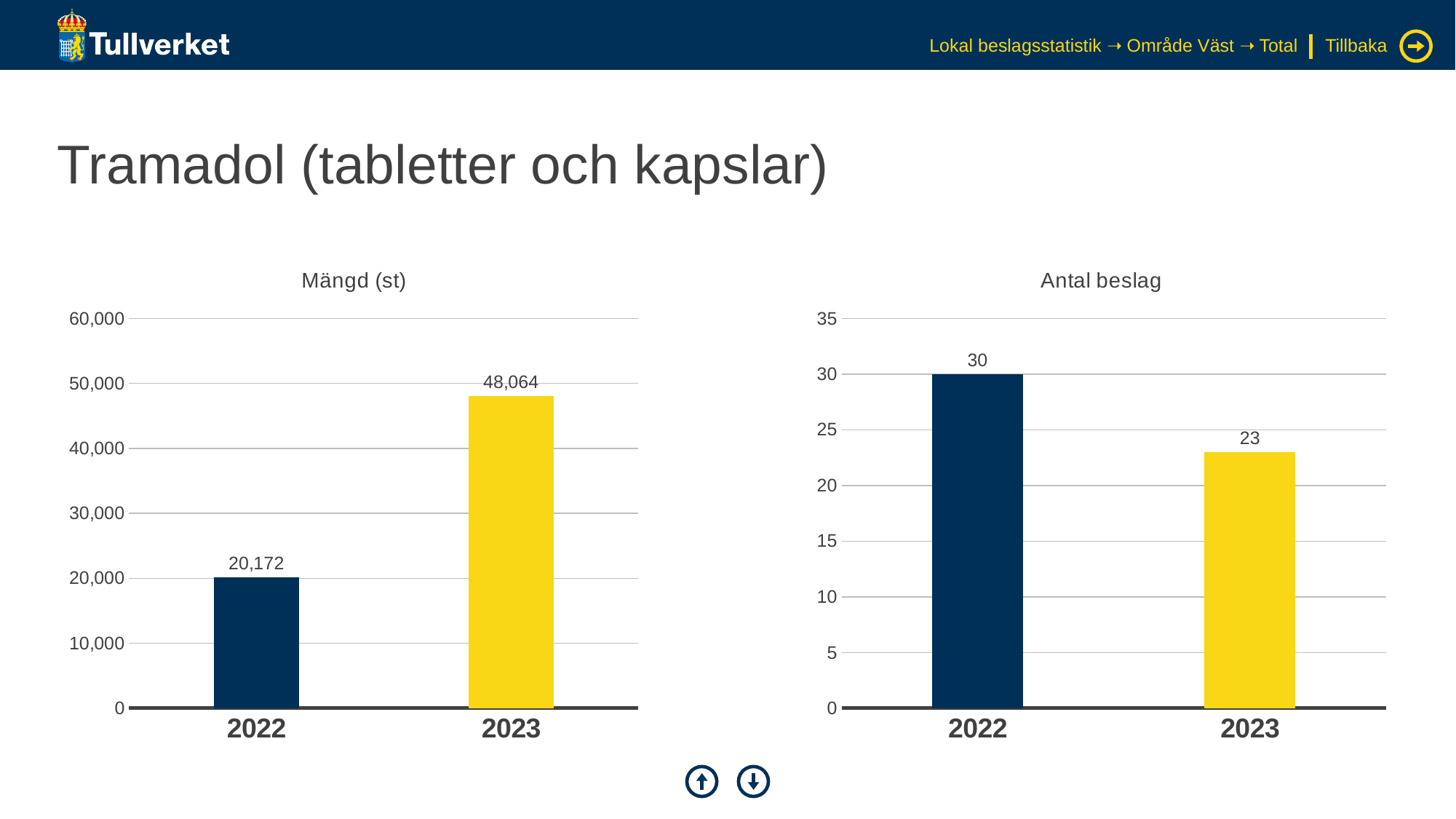
In the "Antal beslag" chart, which year has the lowest value? 2023 In the "Mängd (st)" chart, what is the value for 2022? 20,172 What kind of chart is the "Antal beslag" chart? bar chart In the "Antal beslag" chart, is the value for 2022 larger or smaller than the value for 2023? larger In the "Mängd (st)" chart, do the values rise or fall from 2022 to 2023? rise In the "Mängd (st)" chart, what is the difference between the 2023 and 2022 values? 27,892 In the "Antal beslag" chart, what is the value for 2023? 23 In the "Mängd (st)" chart, what is the value for 2023? 48,064 How many categories are shown on the x axis of the "Mängd (st)" chart? 2 In the "Antal beslag" chart, what is the difference between the 2022 and 2023 values? 7 In the "Mängd (st)" chart, which year has the highest value? 2023 In the "Antal beslag" chart, what is the value for 2022? 30